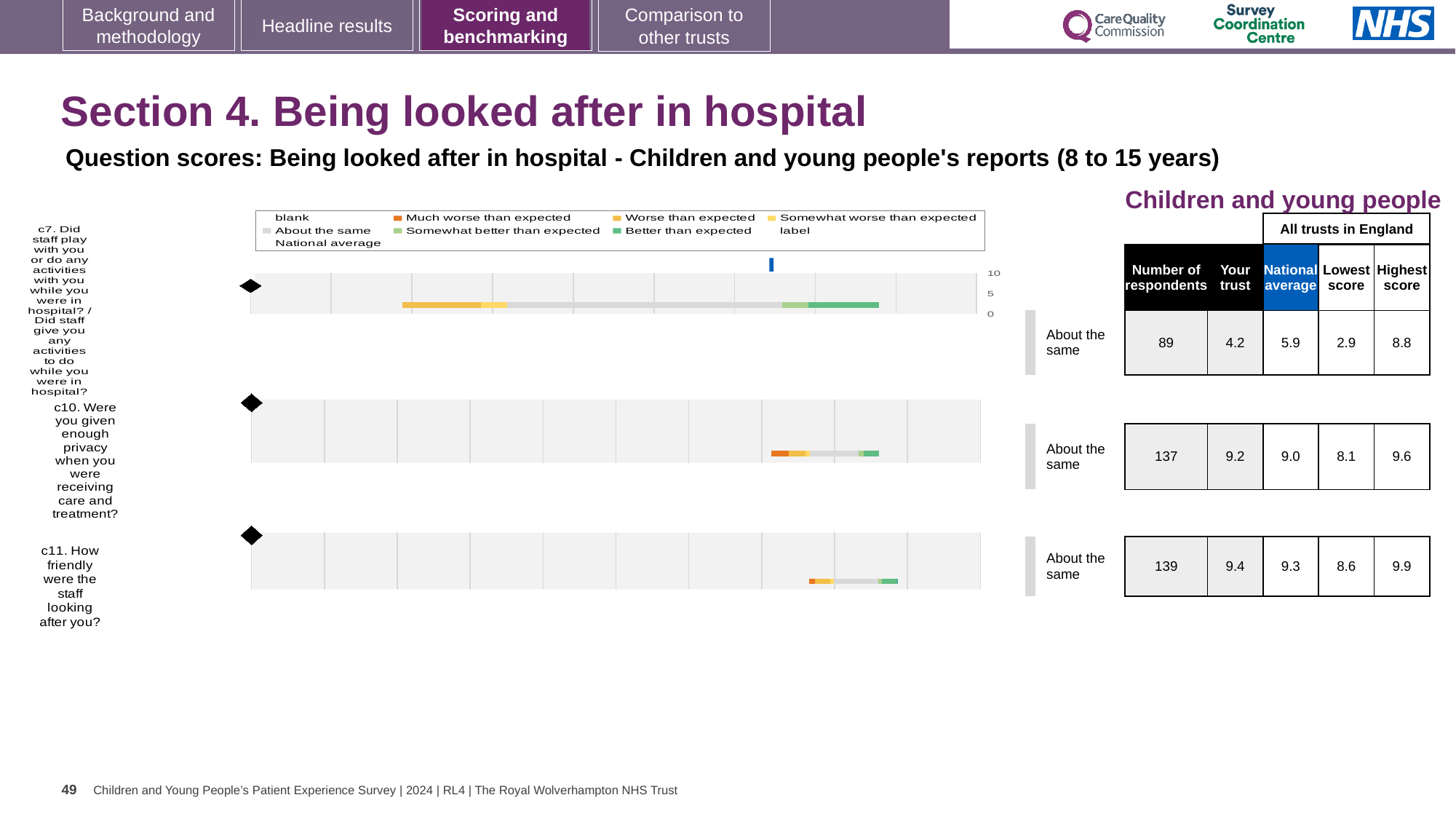
What benchmark category is shown for c7? About the same How many respondents answered c7 (Did staff play with you or do any activities with you while you were in hospital?)? 89 For c10, which is larger: the 'Your trust' score or the national average? Your trust What is the national average score for c11 (How friendly were the staff looking after you?)? 9.3 What kind of chart is used to show the question scores on this slide? bar chart What is the highest score among all trusts in England for c10? 9.6 Which question has the lowest 'Your trust' score? c7 For c7, how much higher is the national average than the 'Your trust' score? 1.7 What is the 'Your trust' score for c10 (Were you given enough privacy when you were receiving care and treatment?)? 9.2 How many questions (categories) are plotted on the slide? 3 Which question has the highest 'Your trust' score? c11 For c11, what is the difference between the highest score and the lowest score among all trusts in England? 1.3